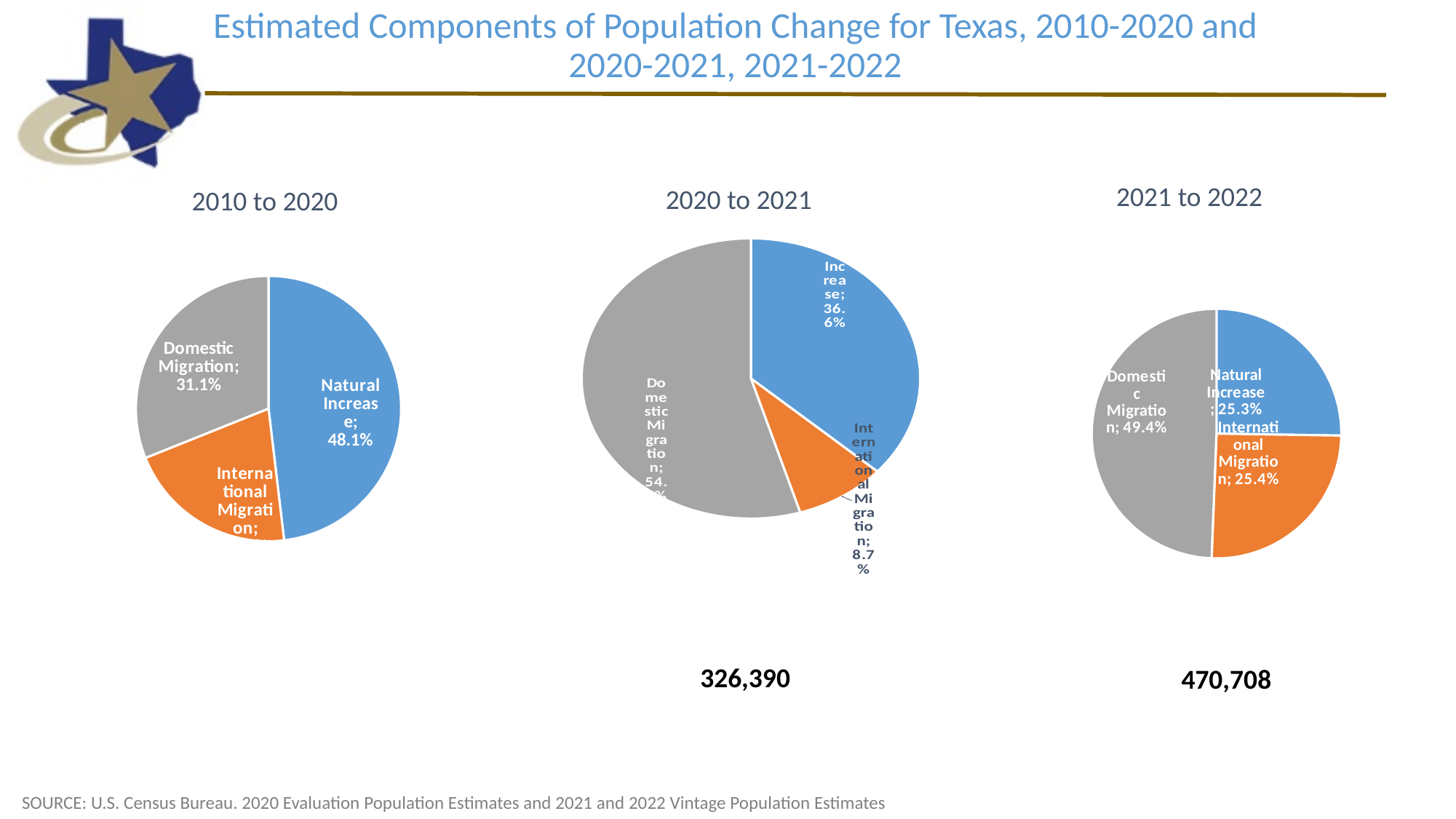
In the 2010 to 2020 chart, what share is Domestic Migration? 31.1% In the 2010 to 2020 chart, how many percentage points larger is Natural Increase than Domestic Migration? 17.0 In the 2020 to 2021 chart, what share is International Migration? 8.7% In the 2010 to 2020 chart, which component has the largest share? Natural Increase In the 2020 to 2021 chart, which component has the smallest share? International Migration In the 2021 to 2022 chart, what share is Domestic Migration? 49.4% In the 2010 to 2020 chart, what share is Natural Increase? 48.1% How many slices does the 2021 to 2022 pie chart have? 3 In the 2020 to 2021 chart, what share is Natural Increase? 36.6% What kind of chart is used for the 2010 to 2020 data? Pie chart In the 2020 to 2021 chart, which component has the largest share? Domestic Migration In the 2021 to 2022 chart, how many percentage points larger is Domestic Migration than International Migration? 24.0